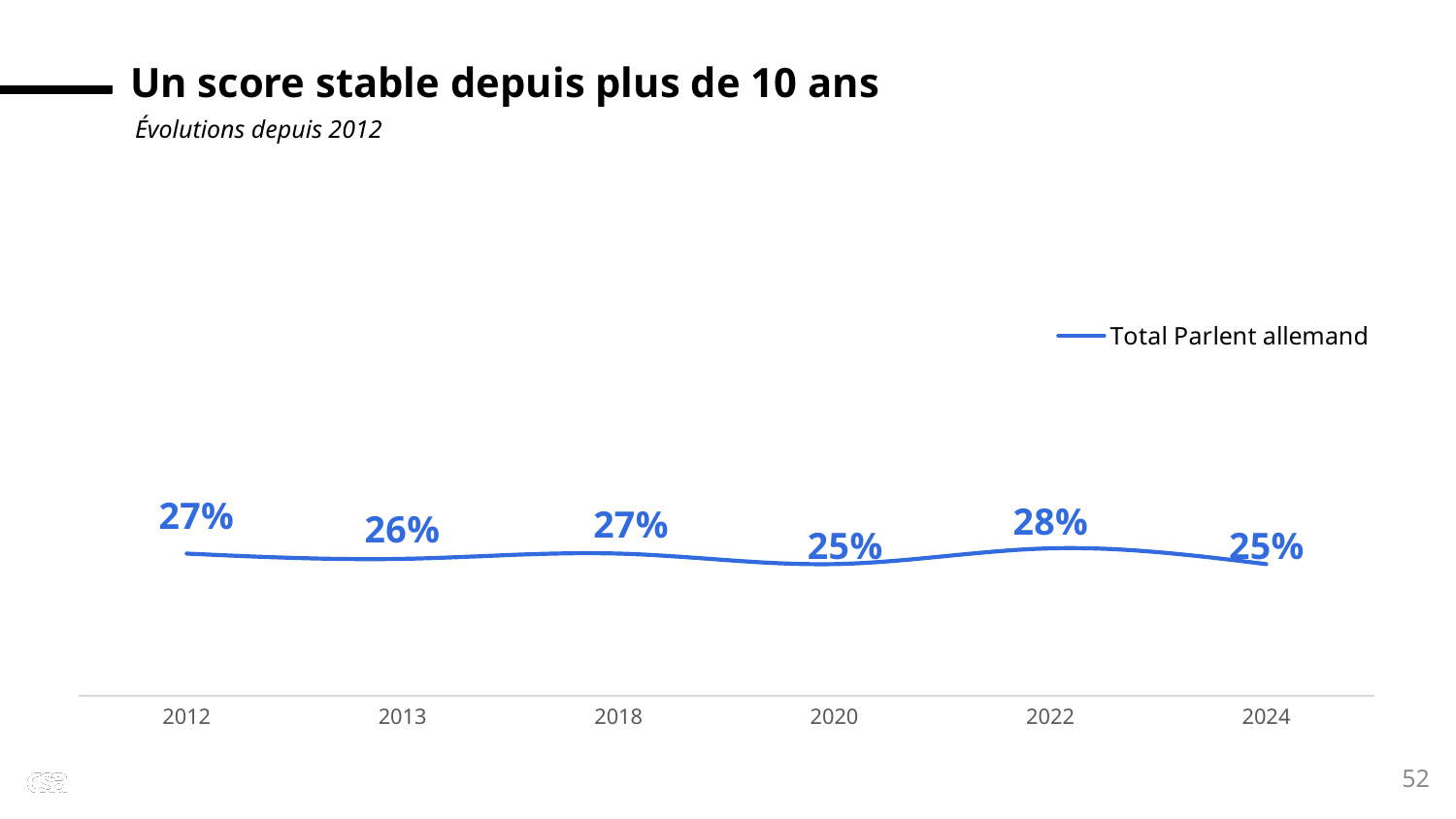
How many years are plotted on the chart? 6 What is the name of the series shown in the legend? Total Parlent allemand What is the difference between the values for 2022 and 2024? 3% What is the difference between the values for 2012 and 2013? 1% What is the value for 2013? 26% What is the value for 2020? 25% Which year has the highest value? 2022 What is the value for 2024? 25% What is the value for 2022? 28% Which is larger, the value for 2018 or the value for 2020? 2018 What kind of chart is shown? line chart What is the value for 2012? 27%